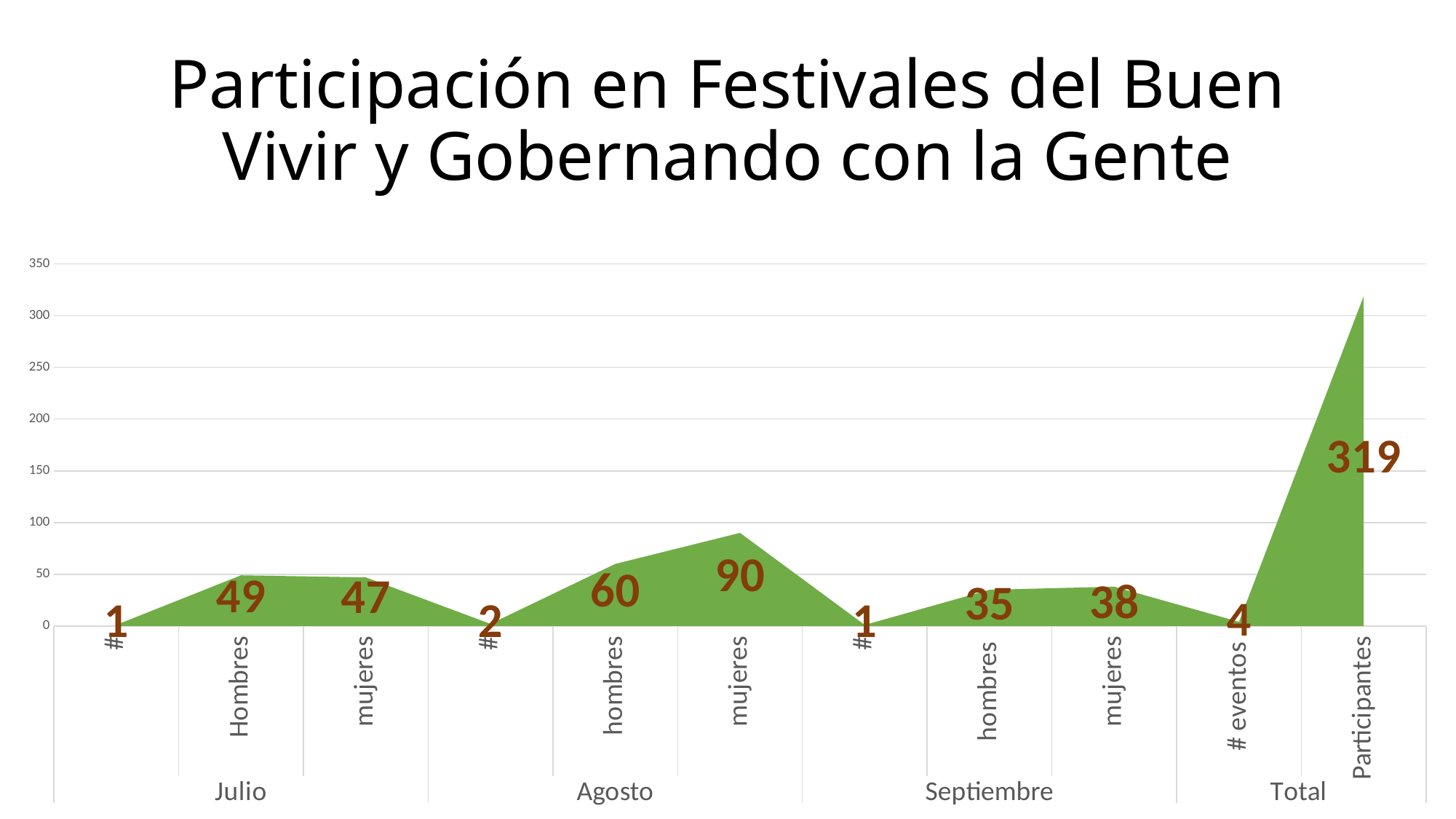
Which is larger, hombres in Septiembre or mujeres in Septiembre? mujeres in Septiembre Which category has the highest value? Participantes What kind of chart is shown on the slide? area chart What is the value for # eventos under Total? 4 Is the value for Participantes greater or less than 300? greater What is the value for Participantes under Total? 319 What is the title of the chart on the slide? Participación en Festivales del Buen Vivir y Gobernando con la Gente What is the difference between mujeres and hombres in Agosto? 30 What is the value for mujeres in Agosto? 90 What is the value for Hombres in Julio? 49 How many month groups are shown on the x axis, including Total? 4 What is the difference between Hombres and mujeres in Julio? 2